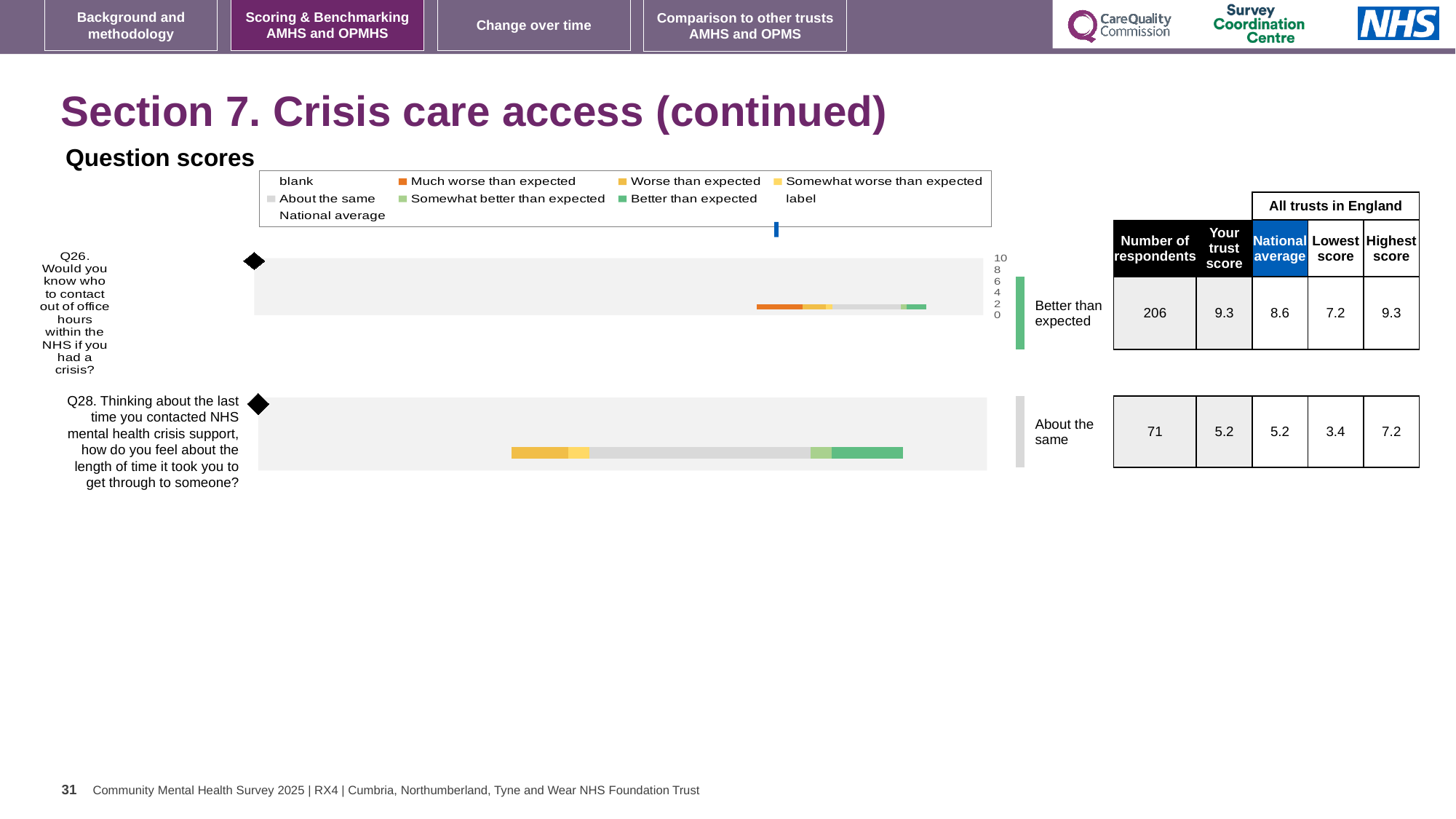
What is the national average score for Q26? 8.6 What kind of chart is used to show the question scores on this slide? bar chart What benchmark category label is shown next to the Q28 bar? About the same How many questions are plotted in the question scores chart? 2 What is the number of respondents for Q28 (length of time to get through to someone)? 71 Which question has the higher trust score, Q26 or Q28? Q26 What is the trust score for Q26 (knowing who to contact out of office hours)? 9.3 What is the lowest score across all trusts in England for Q28? 3.4 What benchmark category label is shown next to the Q26 bar? Better than expected By how much does the trust score for Q26 exceed the national average for Q26? 0.7 What is the difference between the highest and lowest scores for Q28? 3.8 What is the highest score across all trusts in England for Q26? 9.3